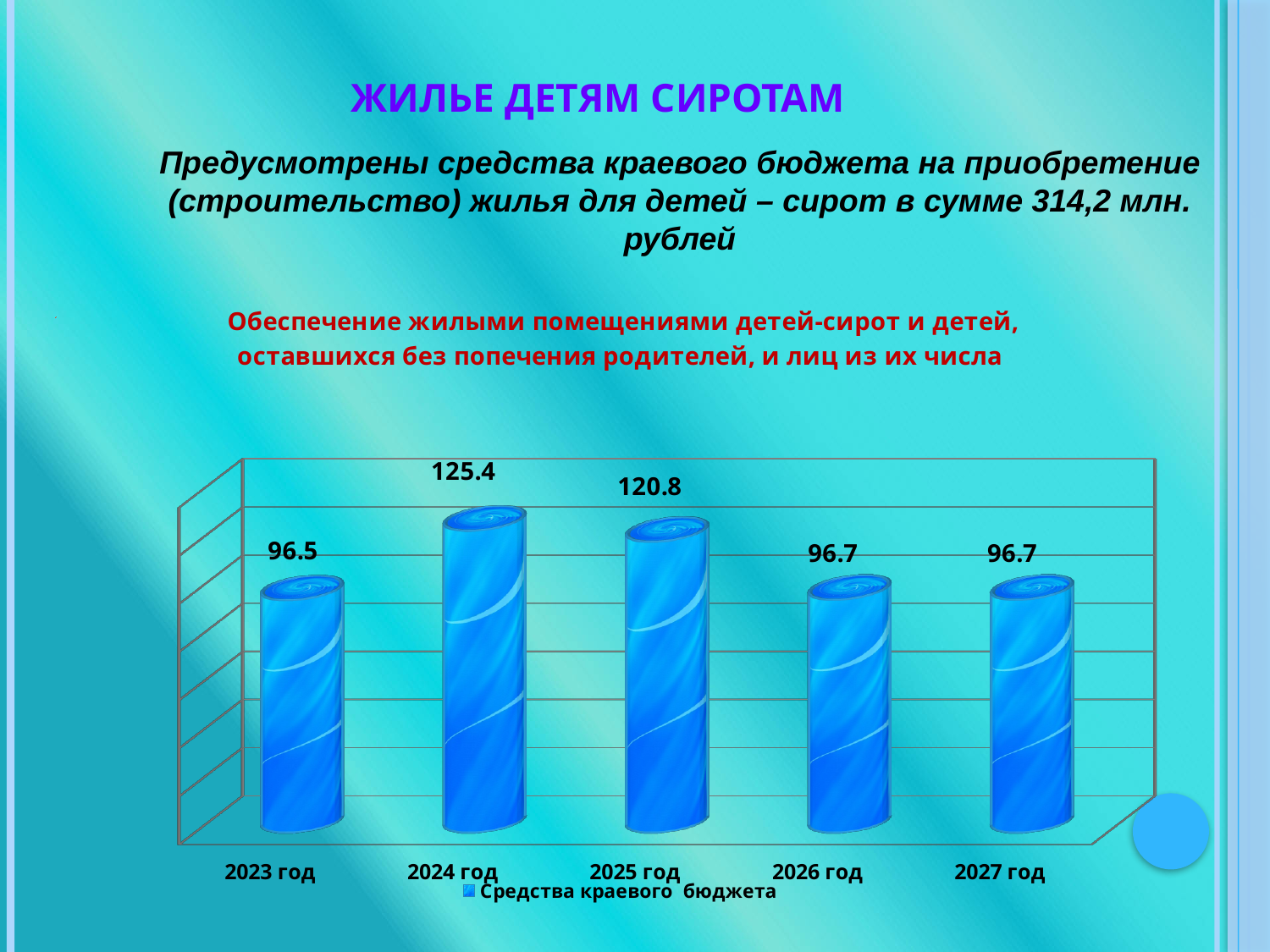
What is the value for 2025 год? 120.8 What kind of chart is shown on the slide? bar chart How many years are shown on the chart? 5 Which is larger, the value for 2025 год or the value for 2026 год? 2025 год What is the legend entry of the chart? Средства краевого бюджета How many series does the legend list? 1 What is the value for 2023 год? 96.5 What is the difference between the values for 2024 год and 2025 год? 4.6 Which year has the highest value? 2024 год What is the value for 2024 год? 125.4 What is the difference between the values for 2024 год and 2023 год? 28.9 What is the value for 2027 год? 96.7